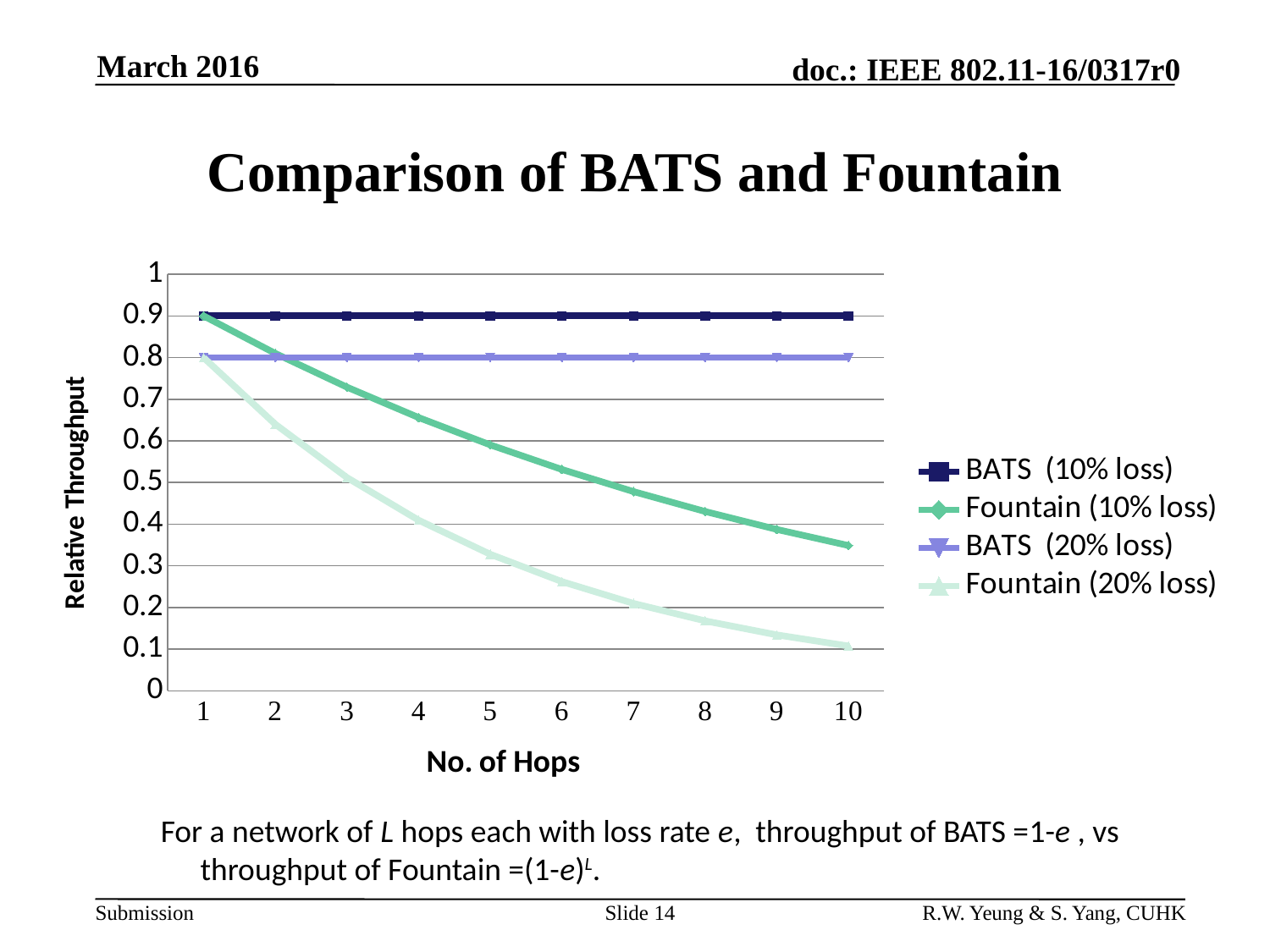
What is the relative throughput of Fountain (10% loss) at 1 hop? 0.9 What is the relative throughput of BATS (10% loss) at 5 hops? 0.9 At 10 hops, which is larger: BATS (20% loss) or Fountain (10% loss)? BATS (20% loss) What is the difference between BATS (10% loss) and BATS (20% loss) at 4 hops? 0.1 How many hop values are plotted along the x axis? 10 What kind of chart is shown on the slide? line chart Which series has the highest relative throughput at 10 hops? BATS (10% loss) What is the relative throughput of BATS (20% loss) at 3 hops? 0.8 Which series has the lowest relative throughput at 10 hops? Fountain (20% loss) How many series does the legend list? 4 Is the value for Fountain (10% loss) at 10 hops greater or less than 0.4? less How does the relative throughput of Fountain (20% loss) change as the number of hops increases? It falls